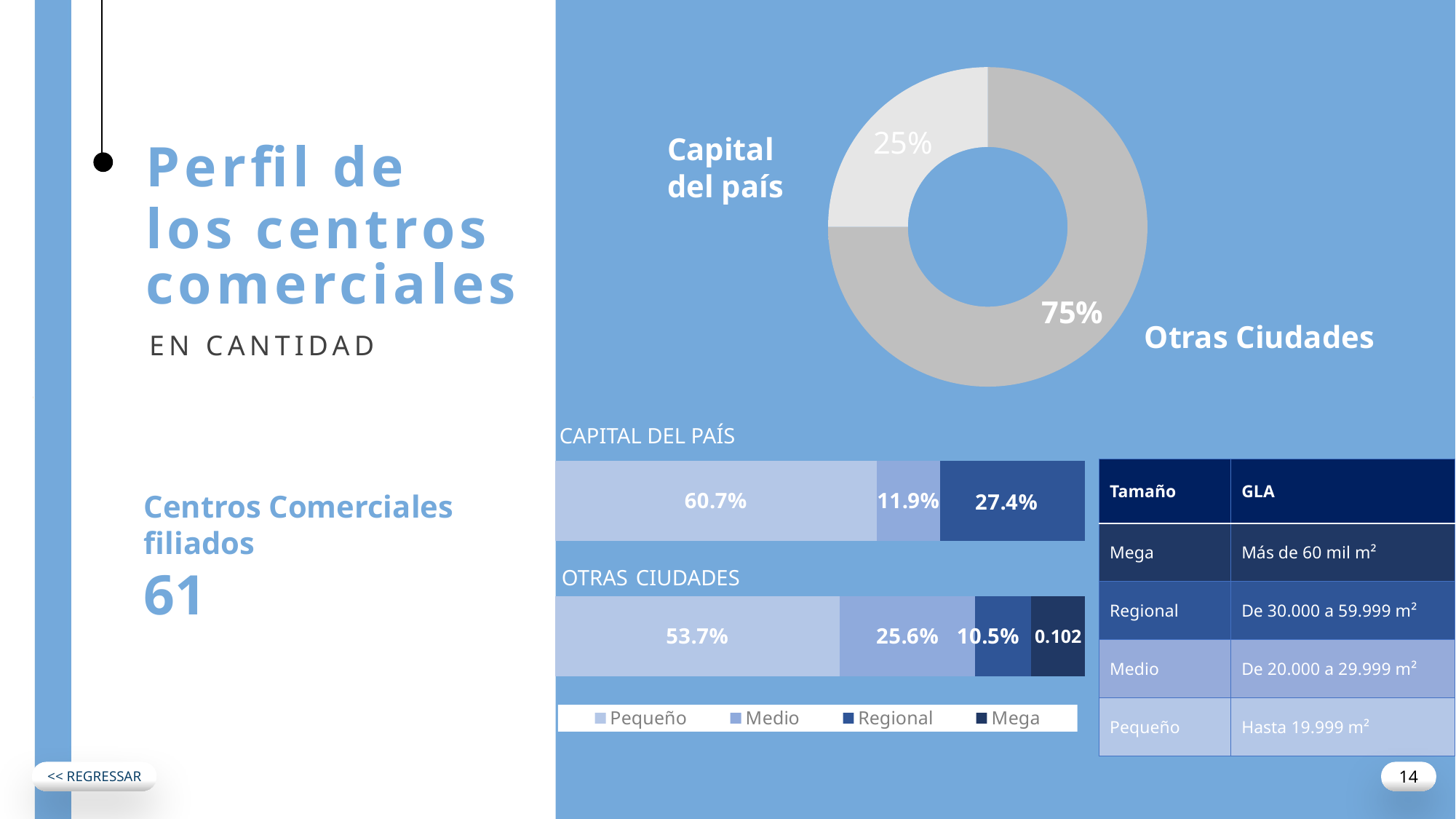
In the Otras Ciudades stacked bar, what is the value for Mega? 0.102 In the donut chart, which category has the larger share, Capital del país or Otras Ciudades? Otras Ciudades What is the difference between the Pequeño value for Capital del País and the Pequeño value for Otras Ciudades? 7.0% In the donut chart, how many categories are shown? 2 In the Capital del País stacked bar, what is the value for Regional? 27.4% How many entries does the legend of the stacked bar charts list? 4 In the donut chart, what share is shown for Capital del país? 25% In the Capital del País stacked bar, what is the value for Pequeño? 60.7% In the Otras Ciudades stacked bar, which segment is the largest? Pequeño In the Capital del País stacked bar, which segment is the smallest? Medio In the donut chart, what share is shown for Otras Ciudades? 75% In the Otras Ciudades stacked bar, what is the value for Medio? 25.6%